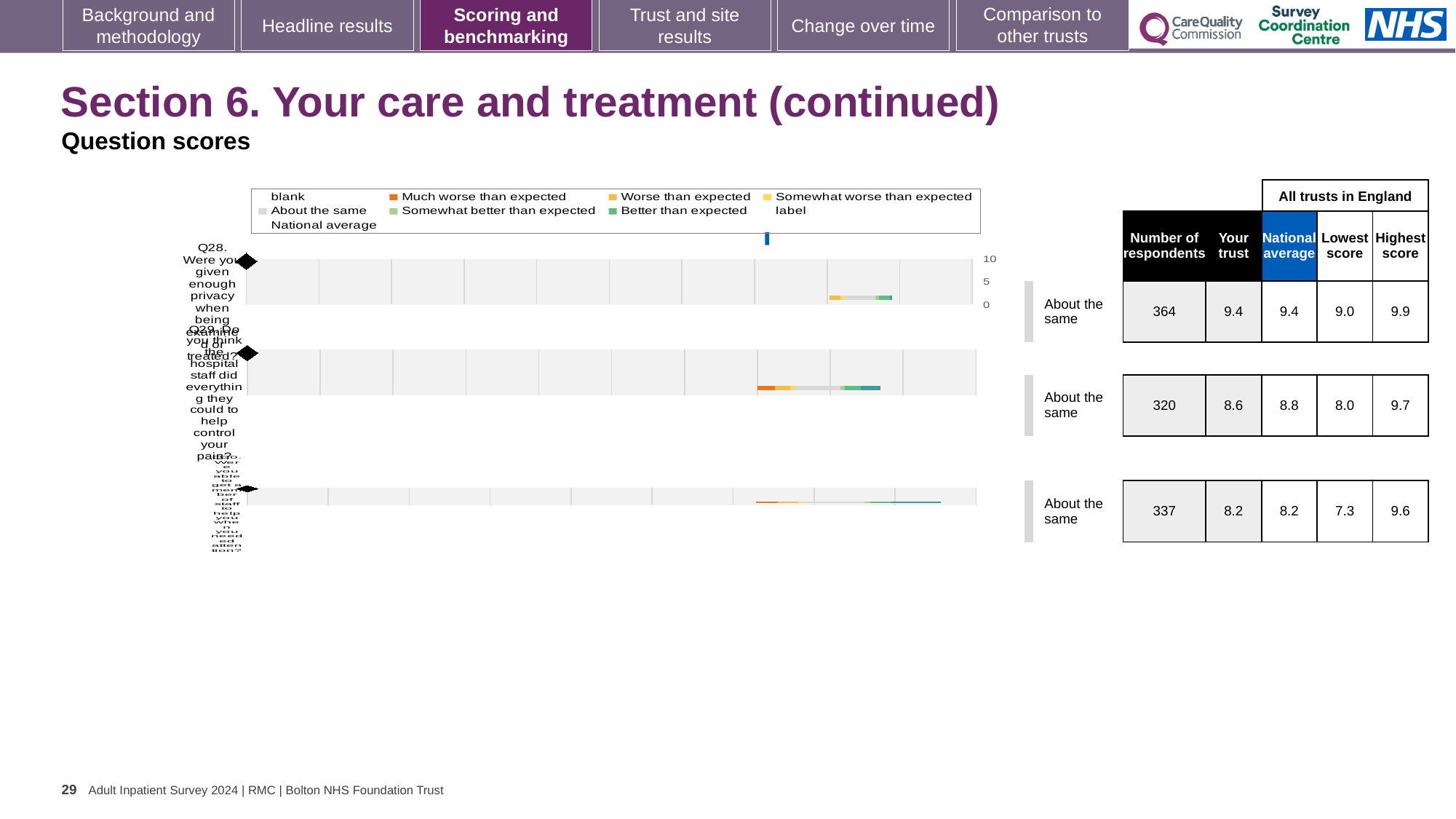
Which question has the fewest respondents? Q29 What is the difference between the national average and the 'Your trust' score for Q29? 0.2 How many questions (Q28, Q29, Q30) are charted on this slide? 3 What is the 'Your trust' score for Q28 (privacy when being examined or treated)? 9.4 What is the highest score across all trusts in England for Q30? 9.6 How many respondents answered Q28? 364 What kind of chart is used to show the question scores on this slide? bar chart Which has the larger 'Your trust' score, Q28 or Q30? Q28 What is the lowest score across all trusts in England for Q30 (getting a member of staff to help when needed)? 7.3 Which question has the highest 'Your trust' score? Q28 What benchmark category is shown for Q29? About the same What is the national average score for Q29 (hospital staff helping to control pain)? 8.8